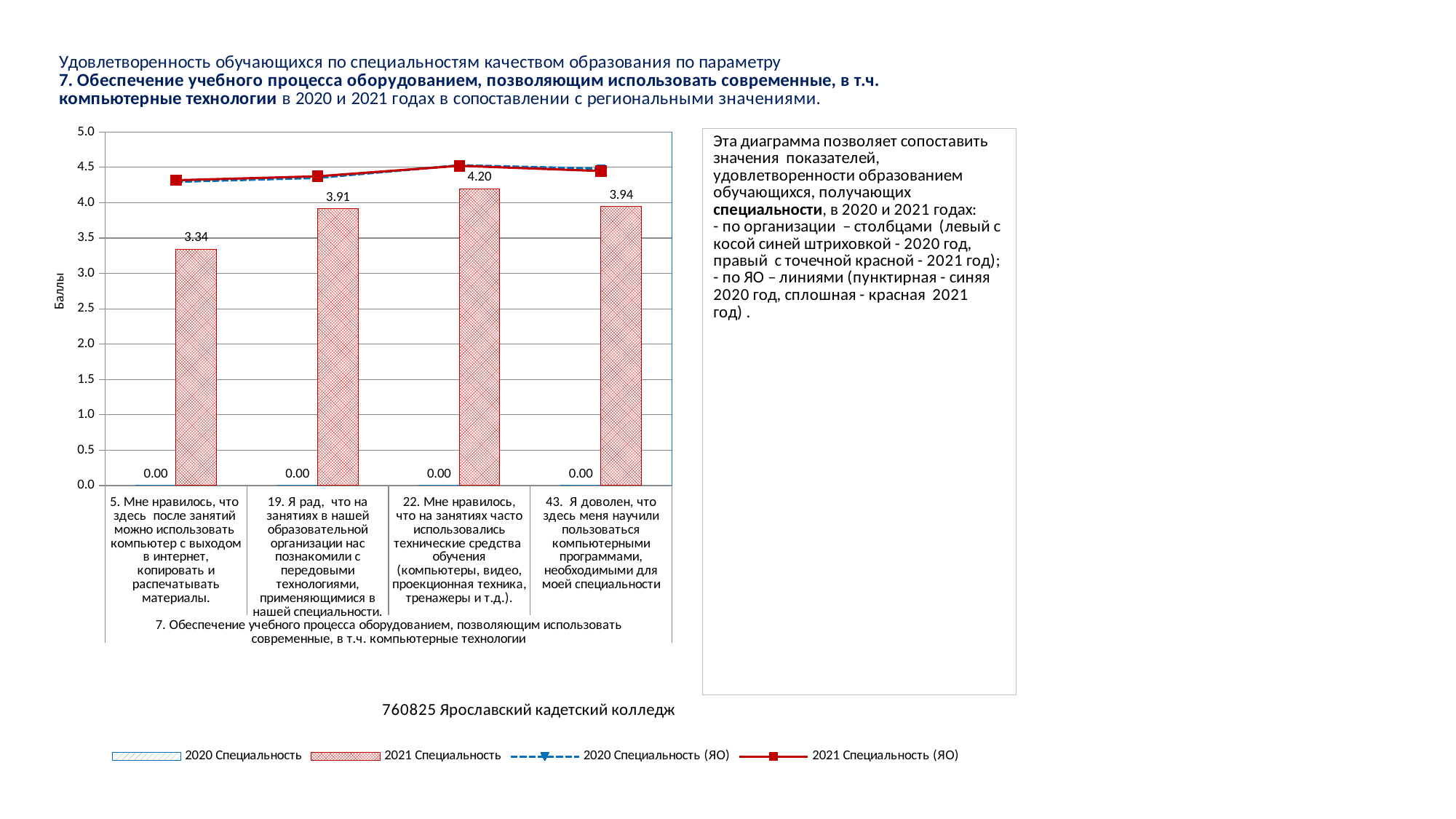
What is the 2020 Специальность value for question 5? 0.00 Which is larger, the 2021 Специальность value for question 19 or for question 43? question 43 (3.94) How many series does the legend list? 4 How many question categories are shown on the x axis? 4 What is the 2021 Специальность value for question 5 ("Мне нравилось, что здесь после занятий можно использовать компьютер с выходом в интернет...")? 3.34 Which question has the highest 2021 Специальность value? 22. Мне нравилось, что на занятиях часто использовались технические средства обучения What is the 2021 Специальность value for question 19 ("Я рад, что на занятиях в нашей образовательной организации нас познакомили с передовыми технологиями...")? 3.91 What is the difference between the 2021 Специальность values for question 22 and question 5? 0.86 Which question has the lowest 2021 Специальность value? 5. Мне нравилось, что здесь после занятий можно использовать компьютер с выходом в интернет What is the 2021 Специальность value for question 22 ("Мне нравилось, что на занятиях часто использовались технические средства обучения...")? 4.20 Is the 2021 Специальность (ЯО) line value for question 22 greater or less than 4.0? greater What is the 2021 Специальность value for question 43 ("Я доволен, что здесь меня научили пользоваться компьютерными программами...")? 3.94